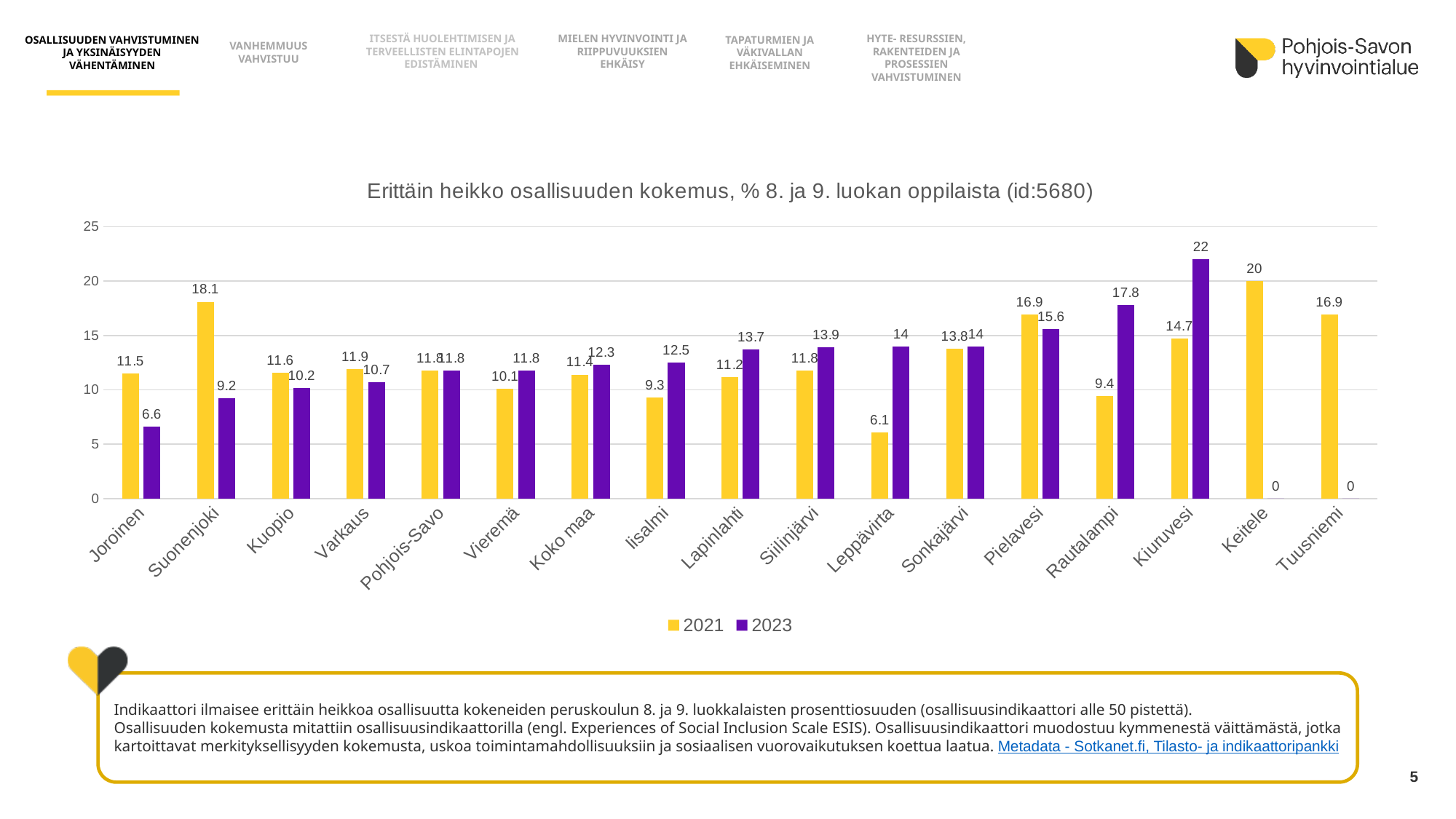
What is the 2021 value for Leppävirta? 6.1 For Rautalampi, which year has the larger value, 2021 or 2023? 2023 How many categories are shown on the x axis? 17 What is the 2023 value for Koko maa? 12.3 What is the difference between the 2021 and 2023 values for Suonenjoki? 8.9 Which category has the lowest 2021 value? Leppävirta Which category has the highest 2023 value? Kiuruvesi Which category has the highest 2021 value? Keitele What kind of chart is shown on the slide? Bar chart How many series does the legend list? 2 What is the 2023 value for Kiuruvesi? 22 What is the difference between the 2023 and 2021 values for Kiuruvesi? 7.3